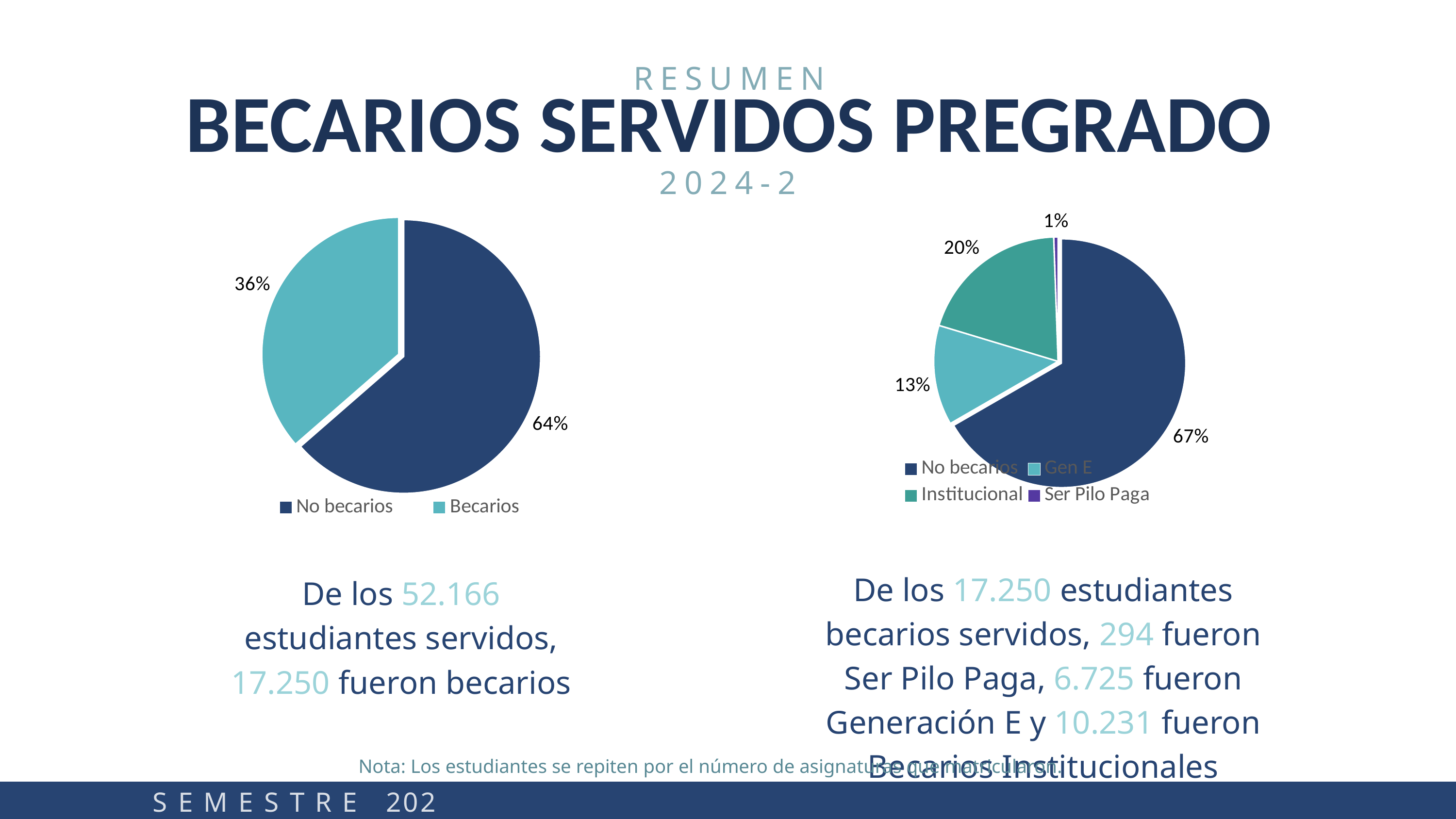
In the left pie chart, which slice is larger, No becarios or Becarios? No becarios In the right pie chart, which category has the largest slice? No becarios In the right pie chart, which category has the smallest slice? Ser Pilo Paga What type of chart is the left chart? Pie chart In the left pie chart, what share is labelled for No becarios? 64% In the right pie chart, what share is labelled for Ser Pilo Paga? 1% How many categories does the legend of the right pie chart list? 4 In the right pie chart, what share is labelled for Gen E? 13% In the left pie chart, what is the difference in percentage points between No becarios and Becarios? 28 How many series does the legend of the left pie chart list? 2 In the right pie chart, what share is labelled for Institucional? 20% In the left pie chart, what share is labelled for Becarios? 36%